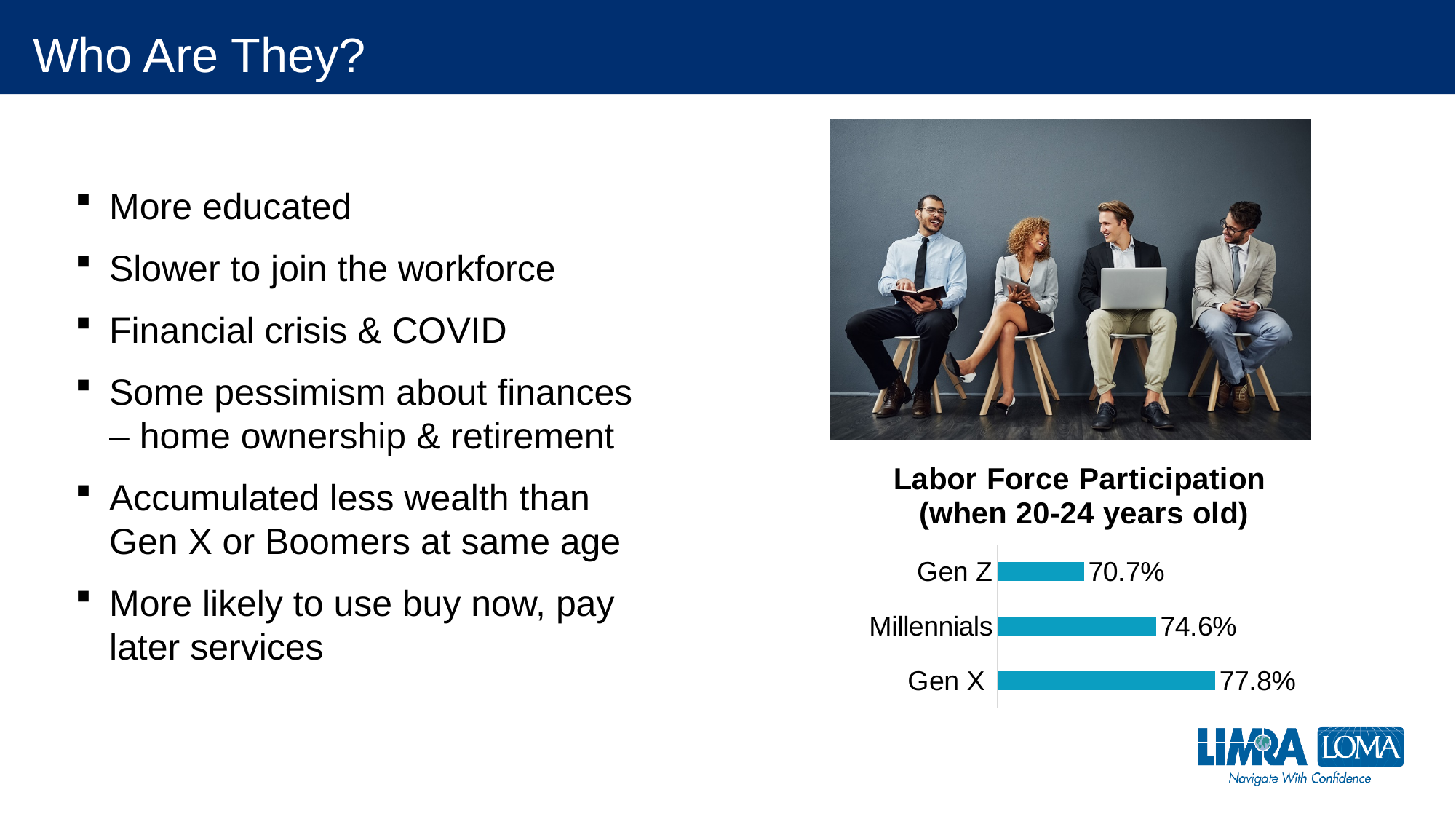
What is the labor force participation value for Millennials? 74.6% Which generation has the lowest labor force participation in the chart? Gen Z What is the labor force participation value for Gen X? 77.8% Which has a higher labor force participation, Millennials or Gen Z? Millennials How many generations are shown in the chart? 3 Which generation has the highest labor force participation in the chart? Gen X What is the labor force participation value for Gen Z? 70.7% What is the difference between the labor force participation of Gen X and Gen Z? 7.1% What is the title of the chart? Labor Force Participation (when 20-24 years old) What kind of chart is used to show labor force participation? Bar chart What colour are the bars in the chart? Blue What is the difference between the labor force participation of Millennials and Gen Z? 3.9%